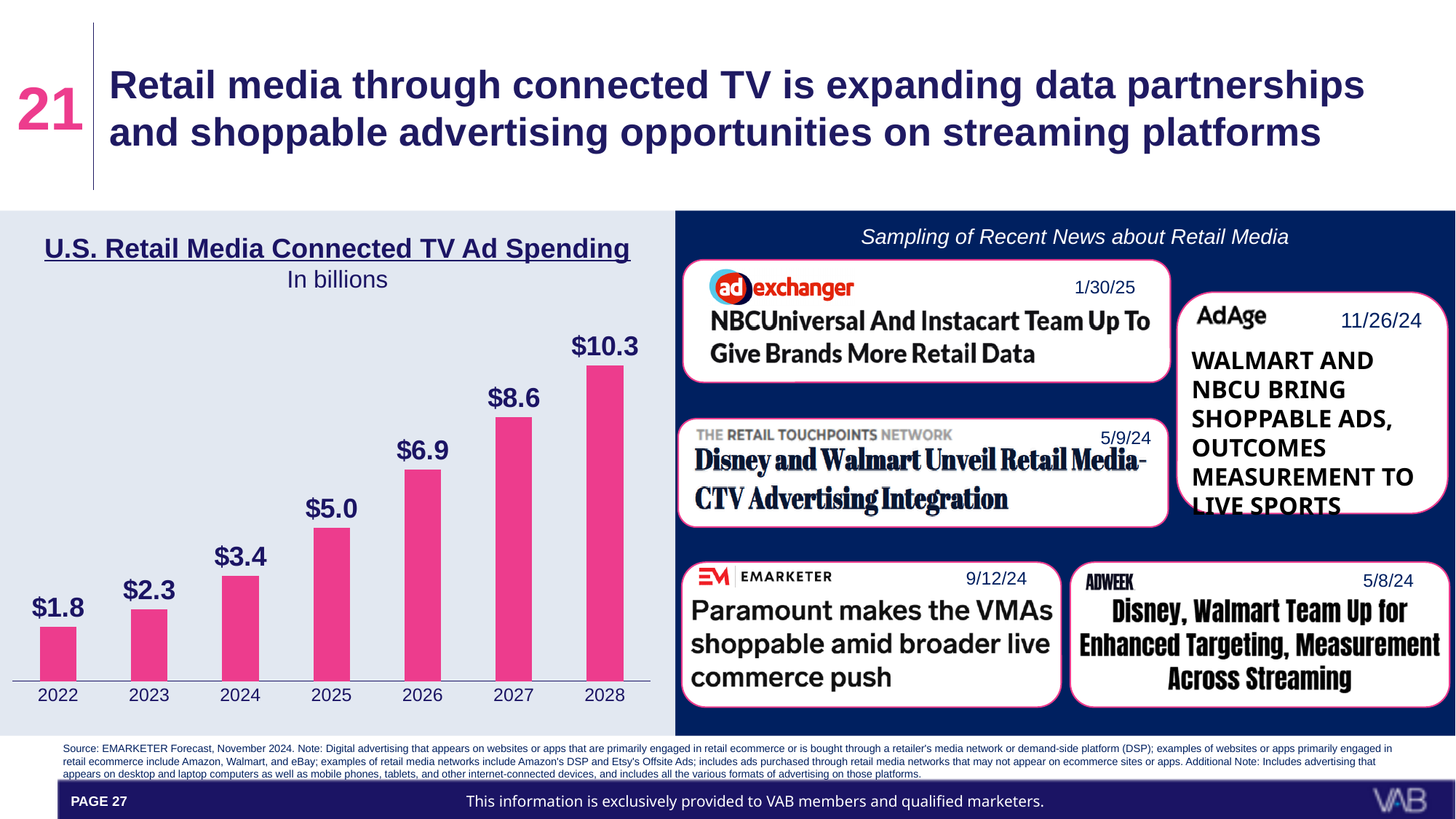
What is the value shown for 2027? $8.6 Which year has the lowest value in the chart? 2022 Which year has the highest U.S. retail media connected TV ad spending? 2028 How many years are shown on the x axis of the chart? 7 In what units are the chart values expressed, according to the subtitle? In billions What is the value shown for 2022 in the U.S. Retail Media Connected TV Ad Spending chart? $1.8 What is the U.S. retail media connected TV ad spending value for 2025? $5.0 What is the difference between the 2028 and 2027 values? $1.7 Which is larger, the value for 2026 or the value for 2025? 2026 What is the difference between the 2024 and 2023 values? $1.1 Do the values rise or fall from 2022 to 2028? Rise What kind of chart is used to show U.S. Retail Media Connected TV Ad Spending? Bar chart